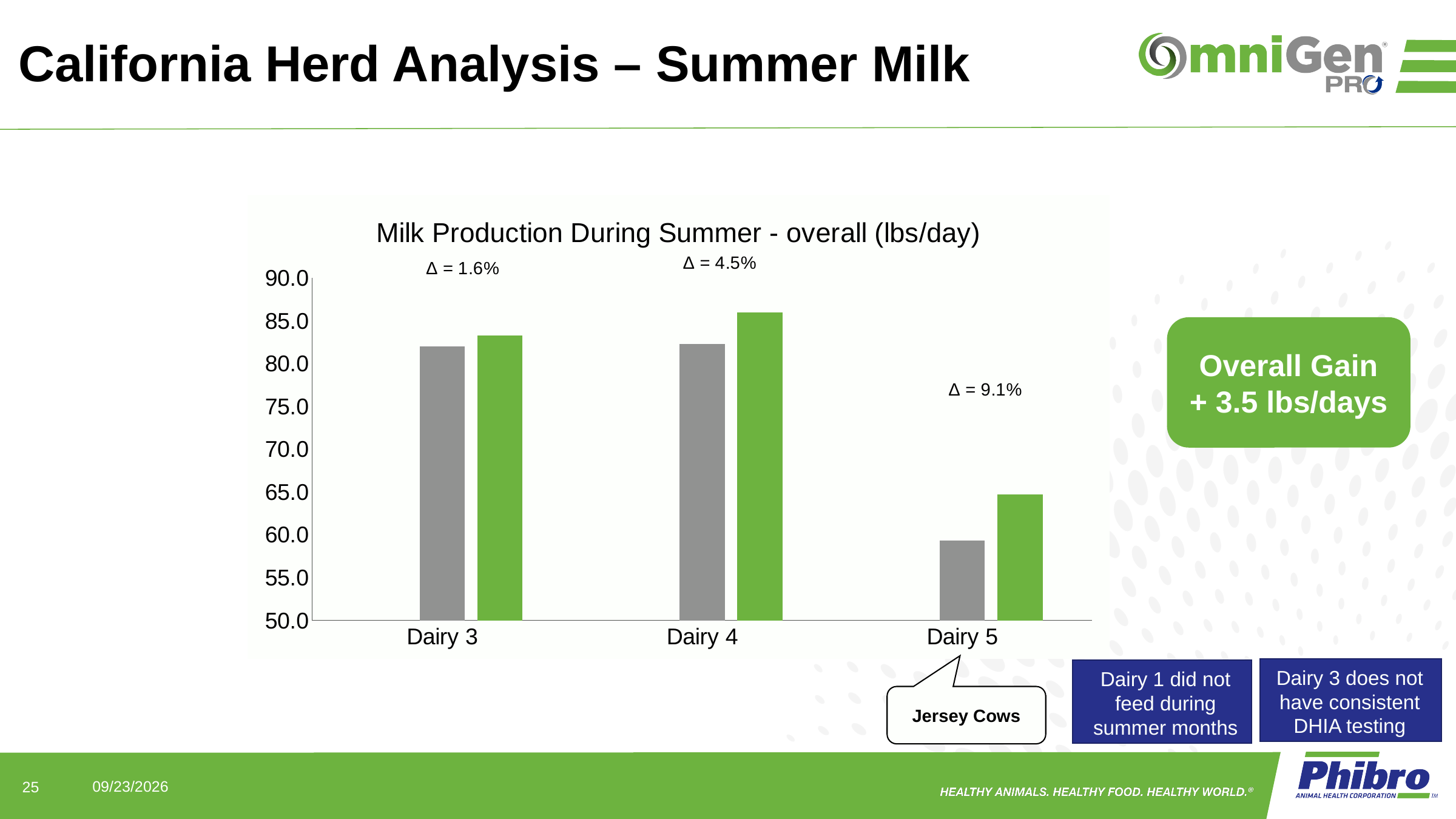
What is the title of the chart? Milk Production During Summer - overall (lbs/day) Is the gray bar for Dairy 5 greater or less than 60.0? less What is the Δ value shown above the bars for Dairy 4? Δ = 4.5% How many dairies are shown on the x axis of the chart? 3 Which dairy has the tallest green bar? Dairy 4 What is the Δ value shown for Dairy 5? Δ = 9.1% What is the Δ value shown above the bars for Dairy 3? Δ = 1.6% Which dairy has the shortest gray bar? Dairy 5 Which dairy has the largest Δ percentage? Dairy 5 What kind of chart is shown on the slide? bar chart Is the green bar for Dairy 4 greater or less than 85.0? greater Which dairy has the smallest Δ percentage? Dairy 3